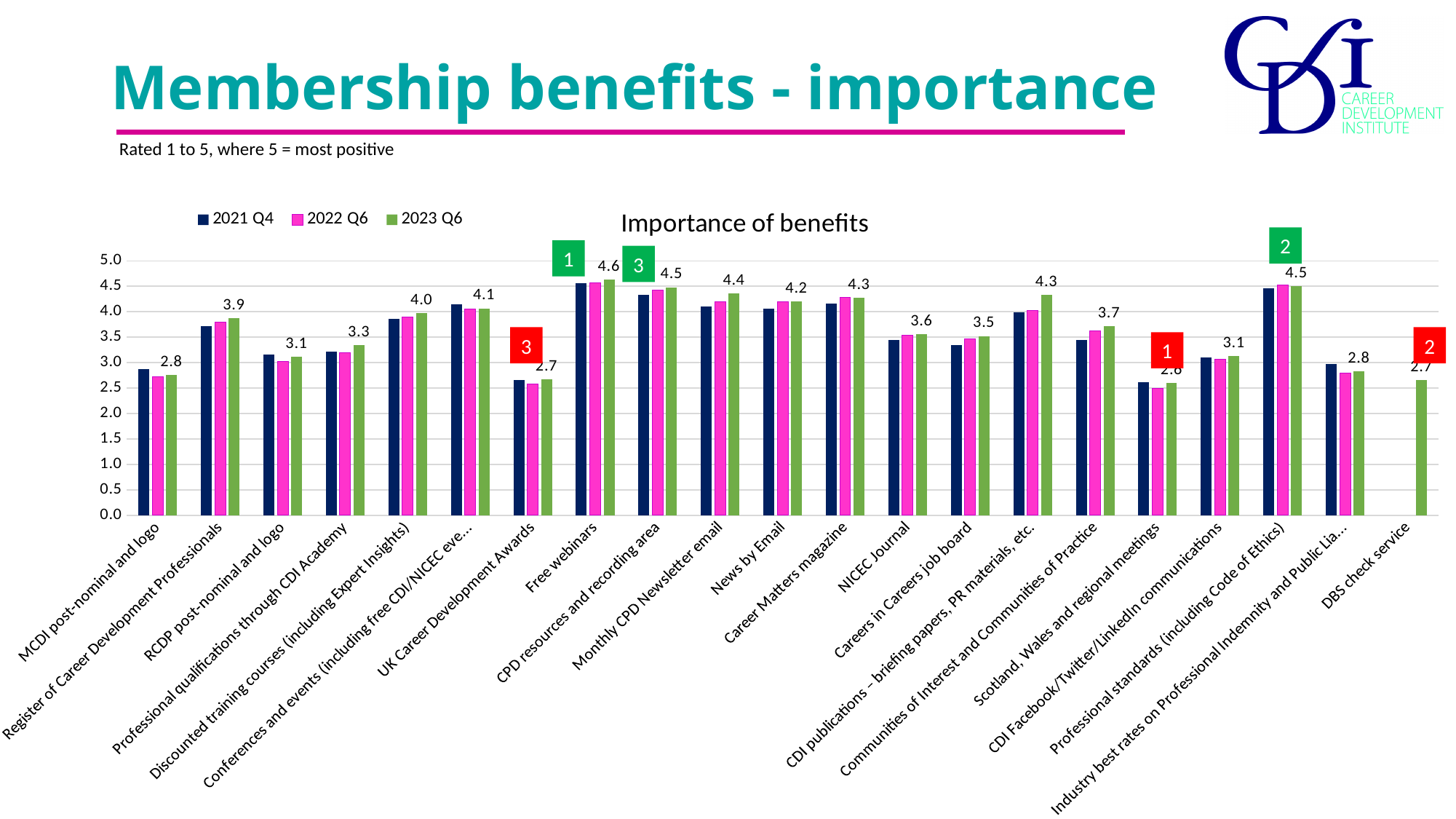
Which category has the highest 2023 Q6 value? Free webinars What is the 2023 Q6 value for Free webinars? 4.6 How many benefit categories are shown on the x axis of the chart? 21 How many series does the legend of the 'Importance of benefits' chart list? 3 What type of chart is shown on the slide? bar chart What is the 2023 Q6 value for NICEC Journal? 3.6 What is the 2023 Q6 value for DBS check service? 2.7 Is the 2021 Q4 value for Professional standards (including Code of Ethics) greater or less than 4.0? greater What is the difference between the 2023 Q6 values for Free webinars and UK Career Development Awards? 1.9 What is the 2023 Q6 value for Monthly CPD Newsletter email? 4.4 What is the title of the chart? Importance of benefits Which has the larger 2023 Q6 value: Register of Career Development Professionals or RCDP post-nominal and logo? Register of Career Development Professionals